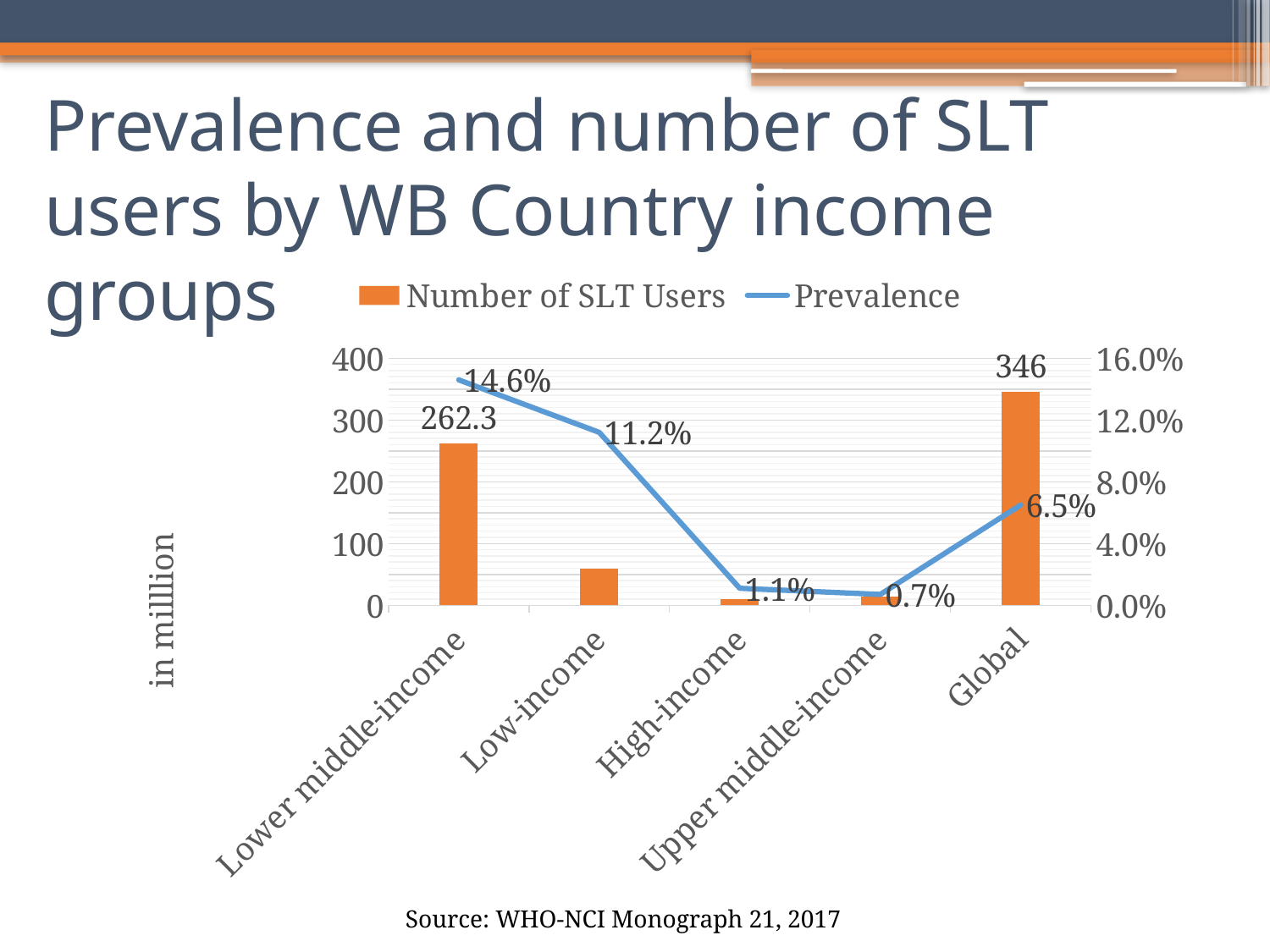
Which income group has the lowest prevalence? Upper middle-income How many categories are shown on the x axis? 5 What kind of chart is shown on the slide? Combination bar and line chart What is the prevalence for the Low-income group? 11.2% What is the difference between the Global number of SLT users and the Lower middle-income number of SLT users? 83.7 Which income group has the highest prevalence? Lower middle-income How many series does the legend list? 2 What is the prevalence for the Lower middle-income group? 14.6% What is the number of SLT users (in million) shown for Global? 346 What is the number of SLT users (in million) for the Lower middle-income group? 262.3 Is the number of SLT users for the Low-income group greater or less than 100? less What is the prevalence for the Upper middle-income group? 0.7%